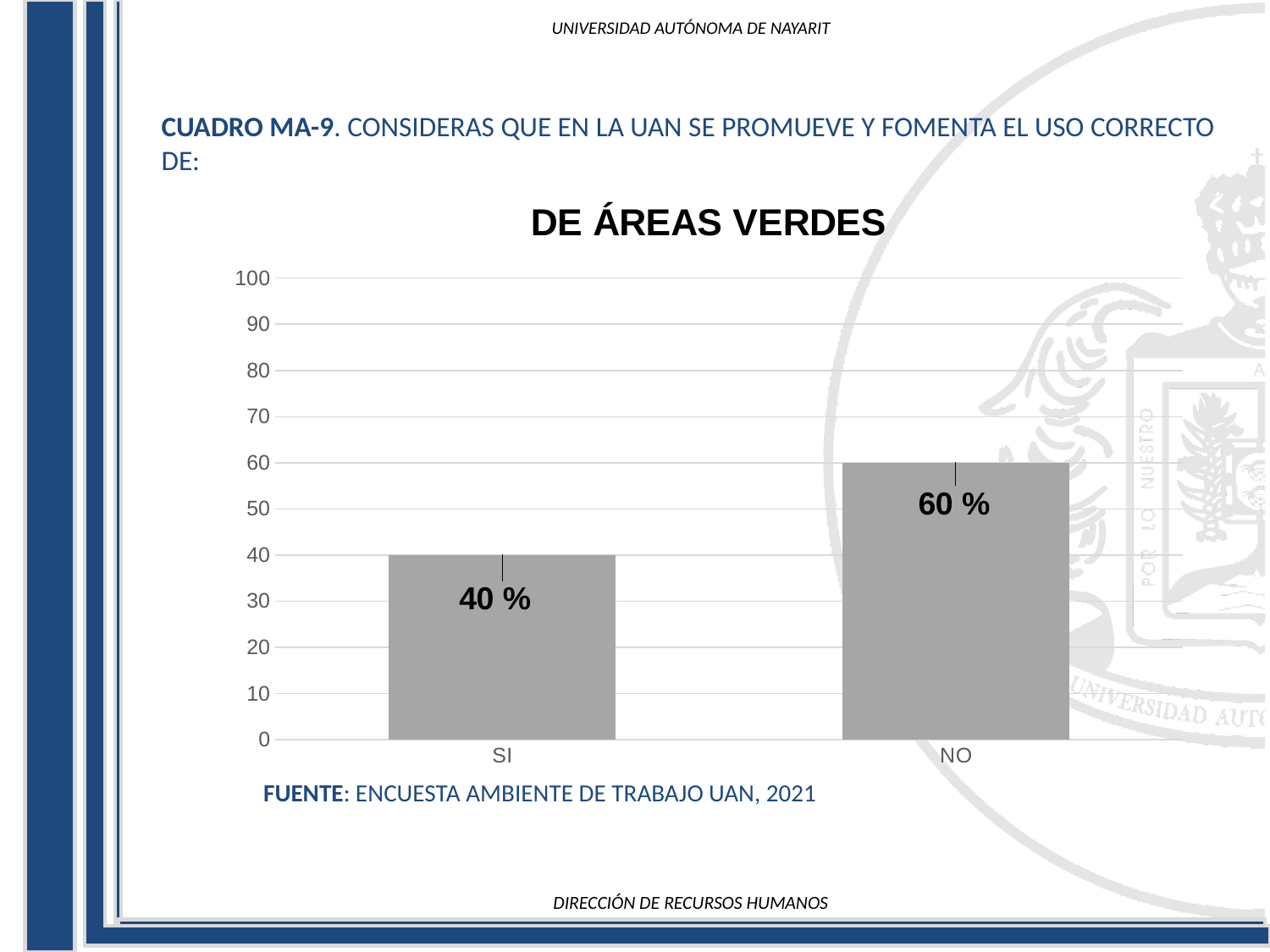
Which category has the lowest value? SI What is the value for SI? 40 % Is the value for NO greater or less than 50? greater What is the difference between the values for NO and SI? 20 % Which category has the highest value? NO What is the value for NO? 60 % What kind of chart is shown on the slide? bar chart How many categories are shown on the x axis? 2 What is the title of the chart? DE ÁREAS VERDES What is the highest value shown on the y axis? 100 Is the value for SI greater or less than 50? less Which is larger, the value for SI or the value for NO? NO